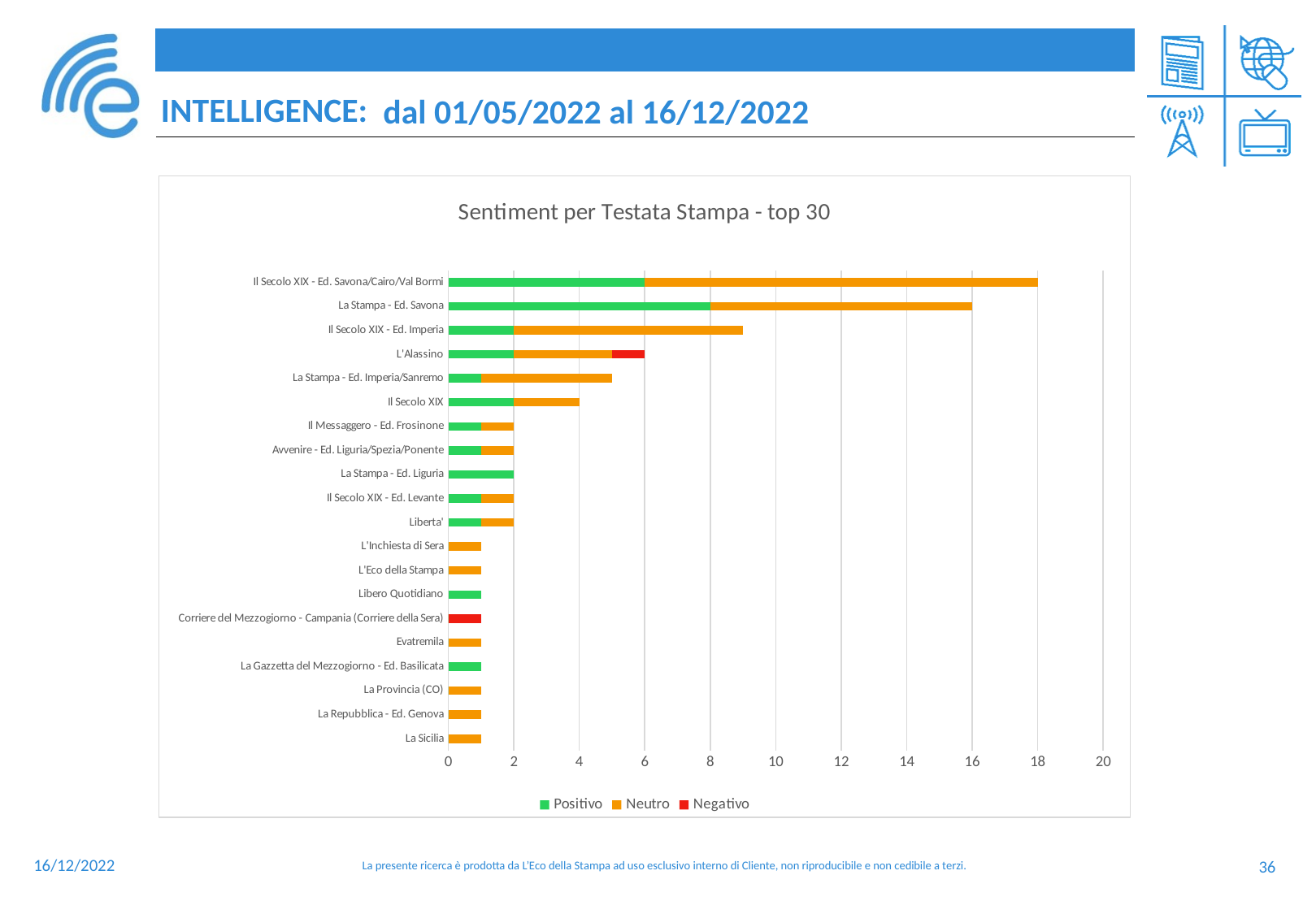
What is the difference between the total bars of Il Secolo XIX - Ed. Savona/Cairo/Val Bormi and La Stampa - Ed. Savona? 2 Is the total value for Il Secolo XIX - Ed. Imperia greater or less than 8? greater Which has a larger total bar, La Stampa - Ed. Savona or Il Secolo XIX - Ed. Imperia? La Stampa - Ed. Savona What is the title of the chart? Sentiment per Testata Stampa - top 30 What is the Positivo value for Il Secolo XIX - Ed. Savona/Cairo/Val Bormi? 6 What is the total bar length for La Stampa - Ed. Savona? 16 What kind of chart is shown on the slide? bar chart How many series does the legend list? 3 What is the total bar length for Il Secolo XIX - Ed. Savona/Cairo/Val Bormi? 18 What is the Positivo value for La Stampa - Ed. Savona? 8 Which testata has the longest total bar? Il Secolo XIX - Ed. Savona/Cairo/Val Bormi How many testate (categories) are plotted on the chart? 20